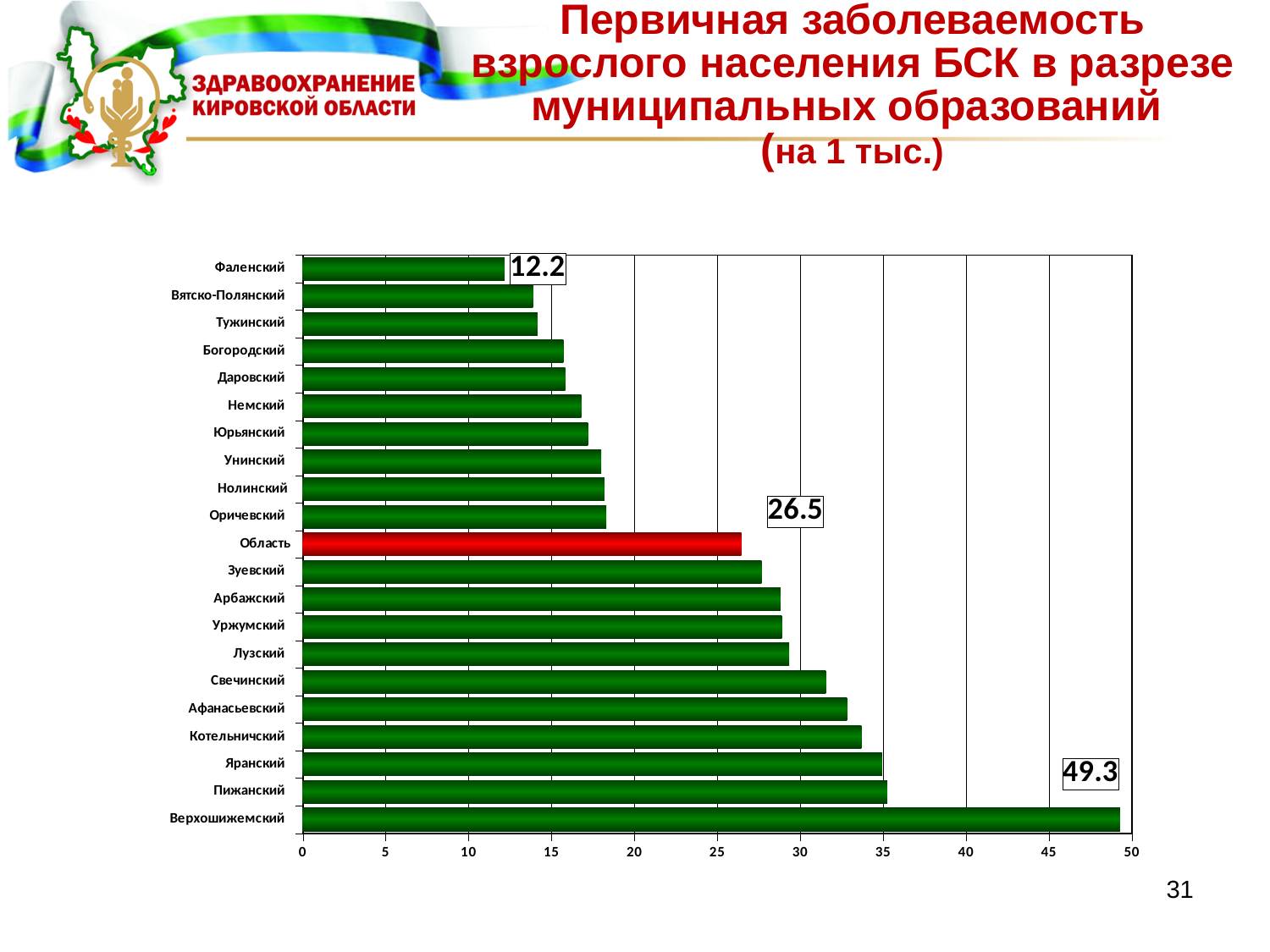
Which category has the lowest value? Фаленский How many categories are shown on the chart? 21 Is the value for Вятско-Полянский greater or less than 15? less What is the difference between the values for Область and Фаленский? 14.3 Is the value for Котельничский greater or less than 30? greater Which category has the highest value? Верхошижемский What is the value for Фаленский? 12.2 What is the value for Верхошижемский? 49.3 What kind of chart is shown on the slide? bar chart What is the difference between the values for Верхошижемский and Область? 22.8 Which is larger, the value for Котельничский or the value for Свечинский? Котельничский What is the value for Область? 26.5